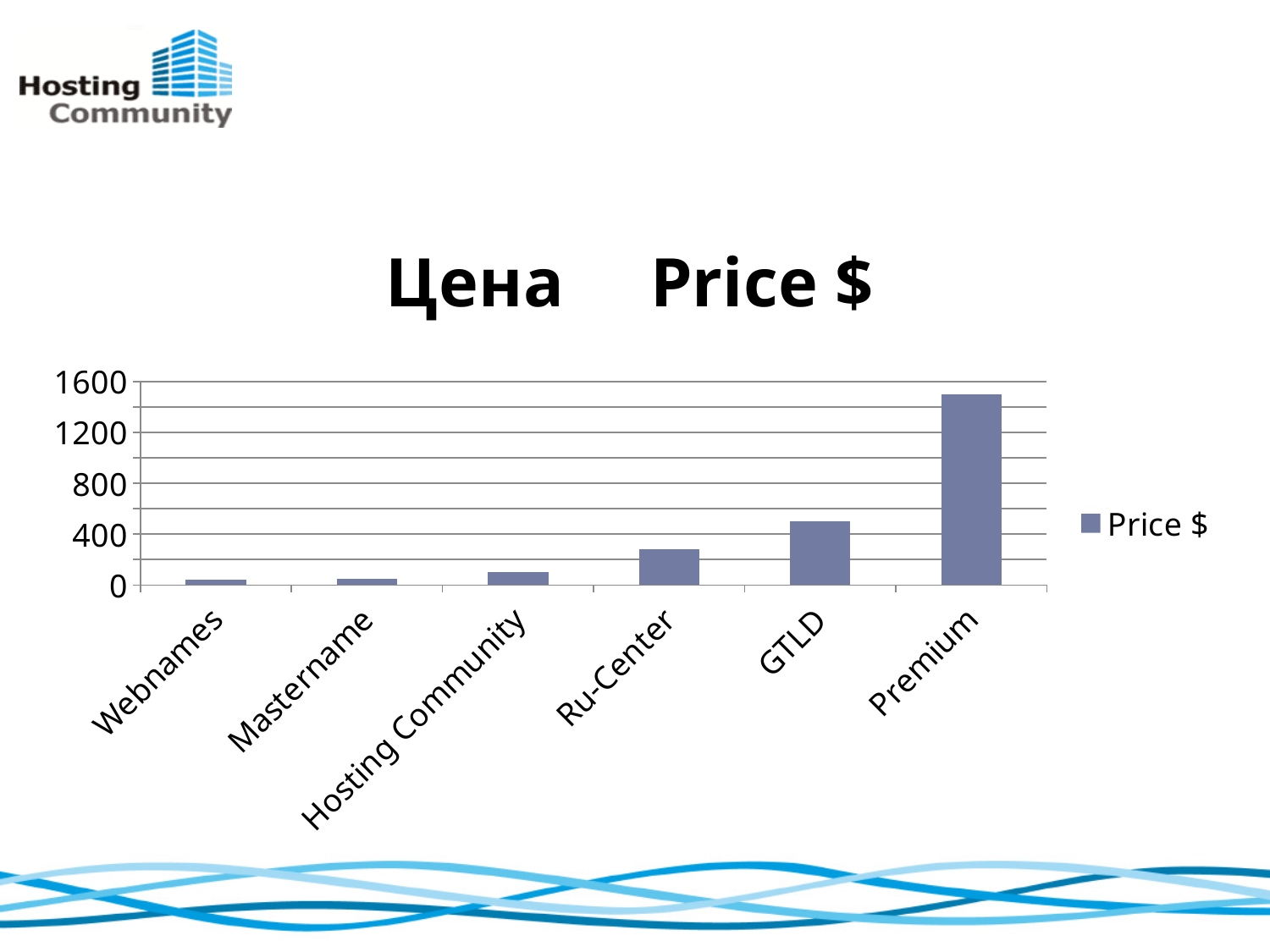
How many categories are shown on the x axis of the chart? 6 Is the value for Premium greater or less than 1200? greater What is the legend entry shown on the chart? Price $ What kind of chart is shown on the slide? bar chart Is the value for Hosting Community greater or less than 400? less Do the values rise or fall moving from left to right along the x axis? rise Is the value for GTLD greater or less than 400? greater Which category has the highest Price $ value? Premium How many series does the chart's legend list? 1 Which has a larger Price $ value, Hosting Community or Ru-Center? Ru-Center Which has a larger Price $ value, GTLD or Ru-Center? GTLD